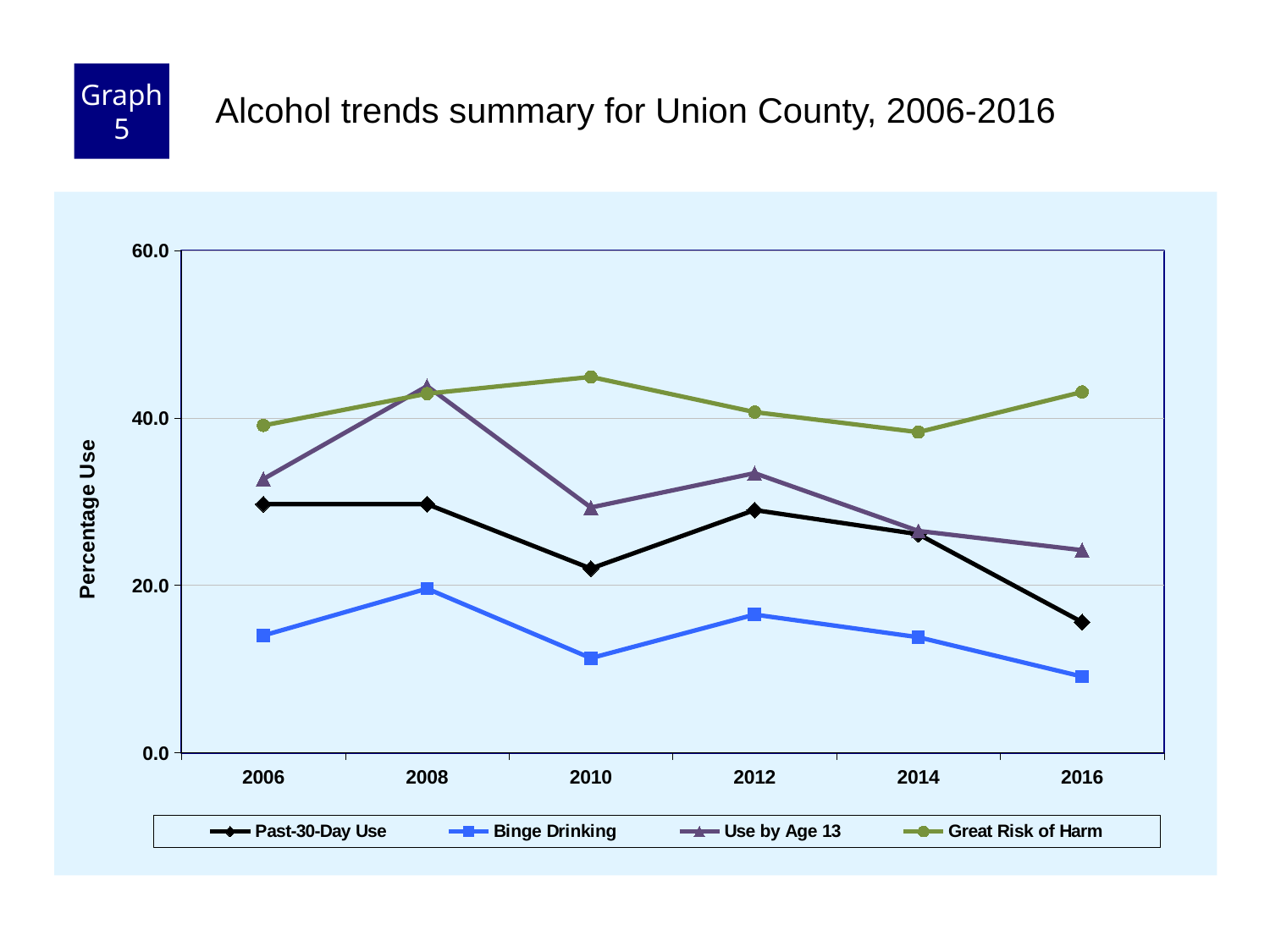
Does Binge Drinking rise or fall from 2012 to 2016? Fall In 2010, which is larger: Use by Age 13 or Past-30-Day Use? Use by Age 13 Is the value for Past-30-Day Use in 2006 greater or less than 20.0? greater What is the label on the y axis? Percentage Use Is the value for Great Risk of Harm in 2010 greater or less than 40.0? greater In which year is Use by Age 13 at its highest? 2008 Is the value for Binge Drinking in 2016 greater or less than 20.0? less How many years are plotted along the x axis? 6 What kind of chart is shown on the slide? Line chart How many series does the legend list? 4 In which year is Past-30-Day Use at its lowest? 2016